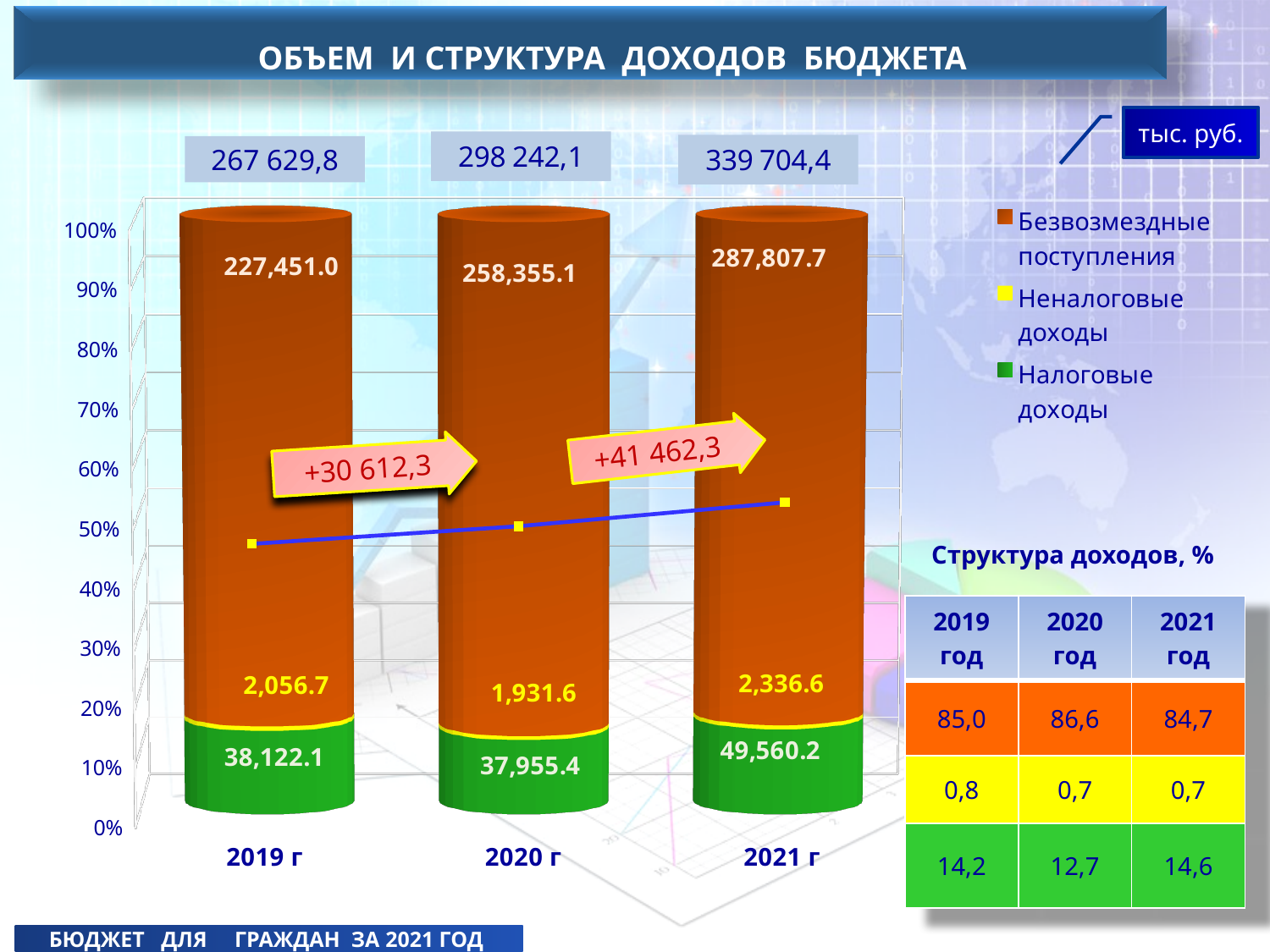
What is the difference between Налоговые доходы in 2021 г and 2019 г? 11,438.1 In which year is Неналоговые доходы lowest? 2020 г How many years (categories) are shown on the chart? 3 What is the value of Налоговые доходы for 2021 г? 49,560.2 What is the value of Неналоговые доходы for 2020 г? 1,931.6 Does the value of Безвозмездные поступления rise or fall from 2019 г to 2021 г? Rise How many series does the legend list? 3 What is the value of Безвозмездные поступления for 2019 г? 227,451.0 In which year is Налоговые доходы highest? 2021 г Which is larger: Налоговые доходы in 2019 г or in 2020 г? 2019 г What is the total budget income shown above the bar for 2021 г? 339 704,4 What kind of chart is shown on the slide? Stacked bar chart